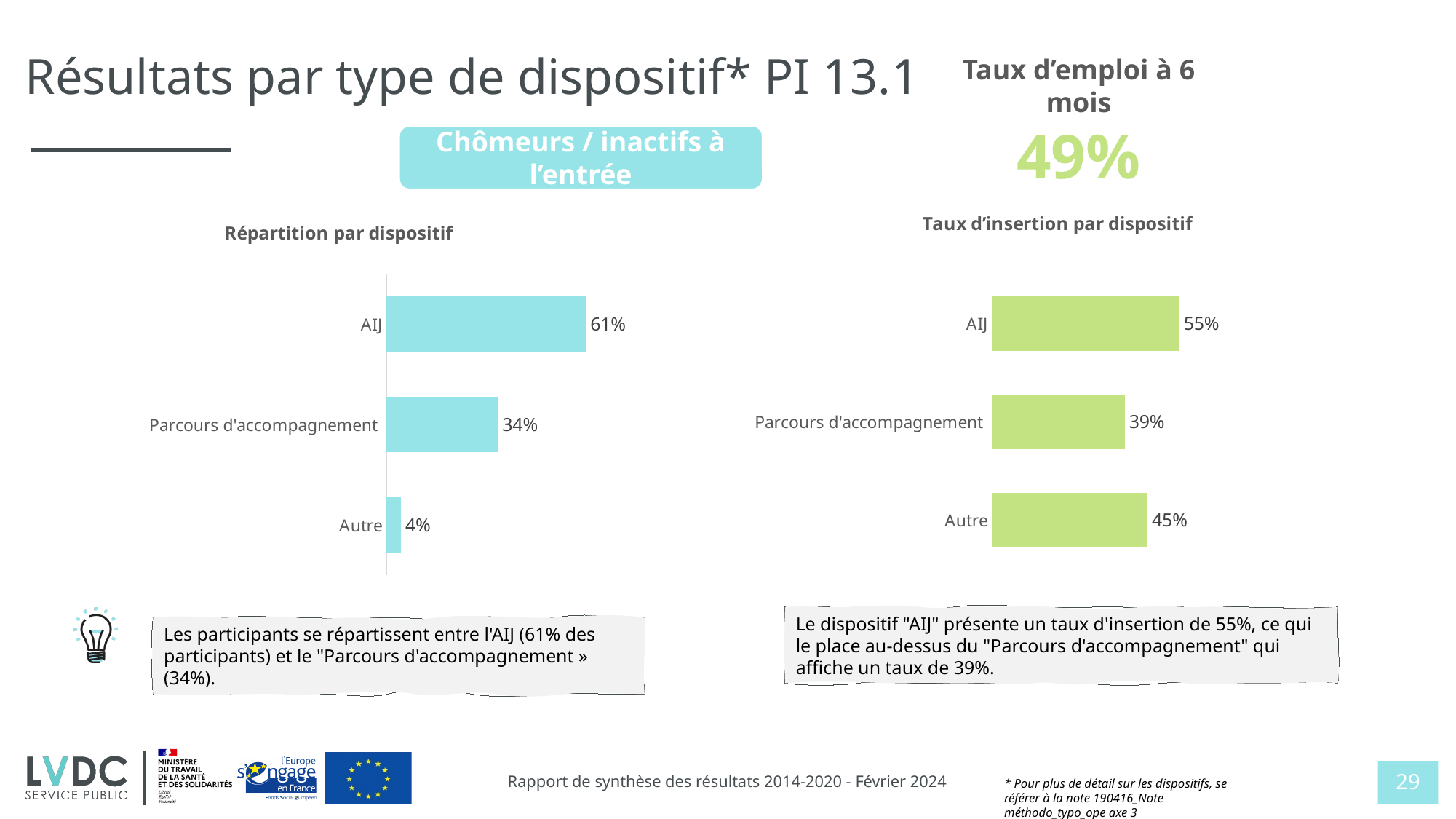
In the 'Taux d'insertion par dispositif' chart, what is the value for Autre? 45% In the 'Répartition par dispositif' chart, what is the value for Parcours d'accompagnement? 34% In the 'Taux d'insertion par dispositif' chart, what is the value for Parcours d'accompagnement? 39% In the 'Taux d'insertion par dispositif' chart, which is larger, Autre or Parcours d'accompagnement? Autre What kind of chart is the 'Taux d'insertion par dispositif' chart? Bar chart How many categories are shown in the 'Répartition par dispositif' chart? 3 In the 'Répartition par dispositif' chart, what is the value for AIJ? 61% In the 'Répartition par dispositif' chart, which category has the lowest value? Autre In the 'Répartition par dispositif' chart, what is the difference between AIJ and Parcours d'accompagnement? 27% In the 'Taux d'insertion par dispositif' chart, what is the difference between AIJ and Autre? 10% What colour are the bars in the 'Répartition par dispositif' chart? Light blue In the 'Taux d'insertion par dispositif' chart, which category has the highest value? AIJ